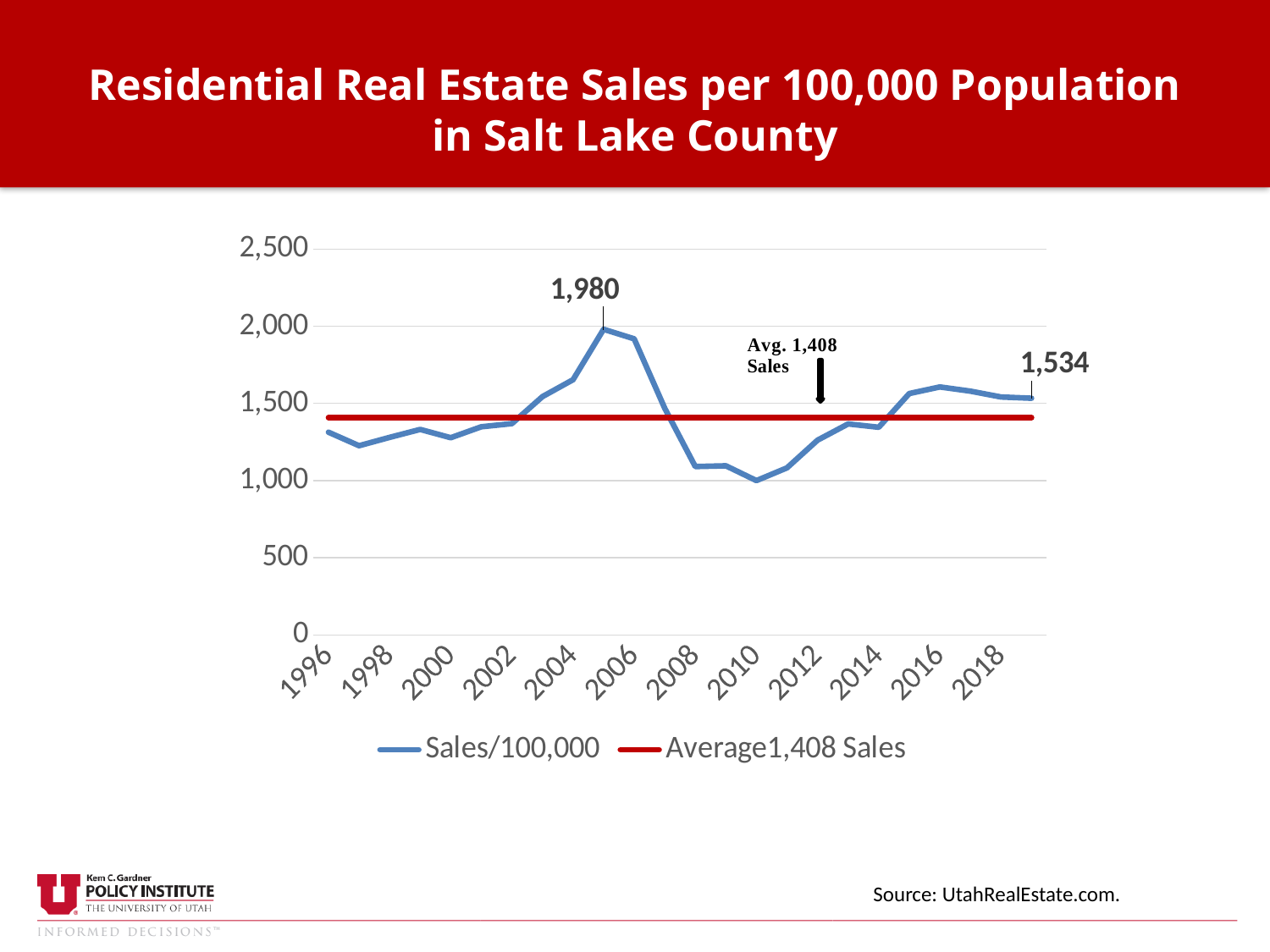
How much higher is the peak value of 1,980 than the average of 1,408? 572 What type of chart is shown on the slide? Line chart How many series does the legend list? 2 What is the highest labeled value of the Sales/100,000 series? 1,980 Is the Sales/100,000 value for 2010 greater or less than 1,500? less What is the title of the chart on the slide? Residential Real Estate Sales per 100,000 Population in Salt Lake County What is the value of the Average line shown on the chart? 1,408 What is the difference between the peak value of 1,980 and the final labeled value of 1,534? 446 Which is larger: the peak labeled value or the final labeled value of the Sales/100,000 series? The peak labeled value (1,980) Is the Sales/100,000 value for 2016 greater or less than 1,500? greater What value is labeled at the last data point of the Sales/100,000 series? 1,534 Does the Sales/100,000 series rise or fall between 2006 and 2010? Fall